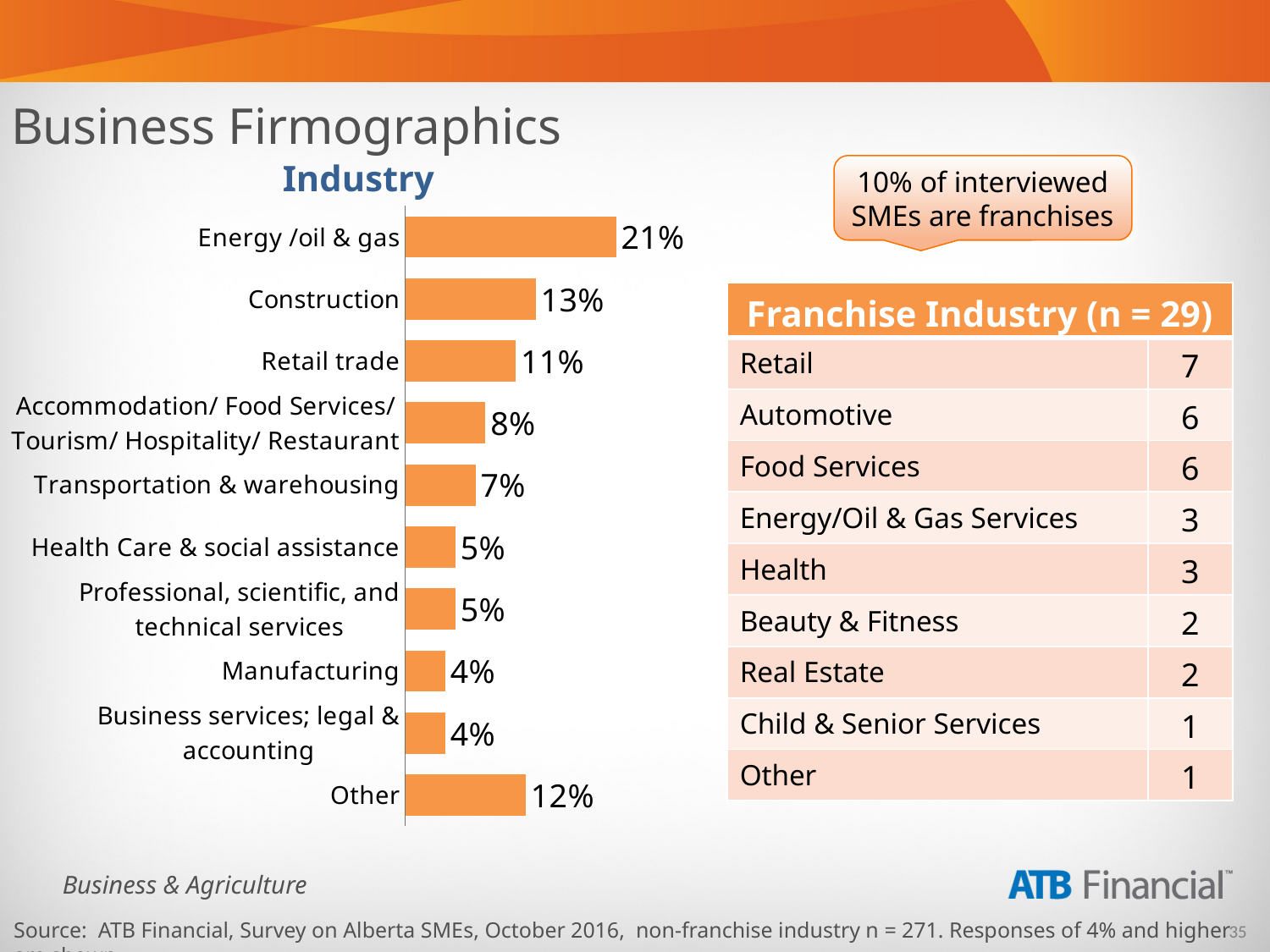
How many industry categories are shown in the Industry bar chart? 10 Which industry has the highest percentage in the Industry chart? Energy /oil & gas What is the value for Construction in the Industry chart? 13% What is the difference between the Energy /oil & gas and Construction percentages? 8% What type of chart is used to show the Industry breakdown? Bar chart What is the value for Transportation & warehousing? 7% What is the title of the bar chart on the slide? Industry What percentage of SMEs are in the Energy /oil & gas industry? 21% Which is larger, the value for Retail trade or the value for Other? Other What percentage is shown for Retail trade? 11% Which two industries in the chart share the lowest value of 4%? Manufacturing and Business services; legal & accounting What is the difference between the Accommodation/ Food Services/ Tourism/ Hospitality/ Restaurant value and the Manufacturing value? 4%